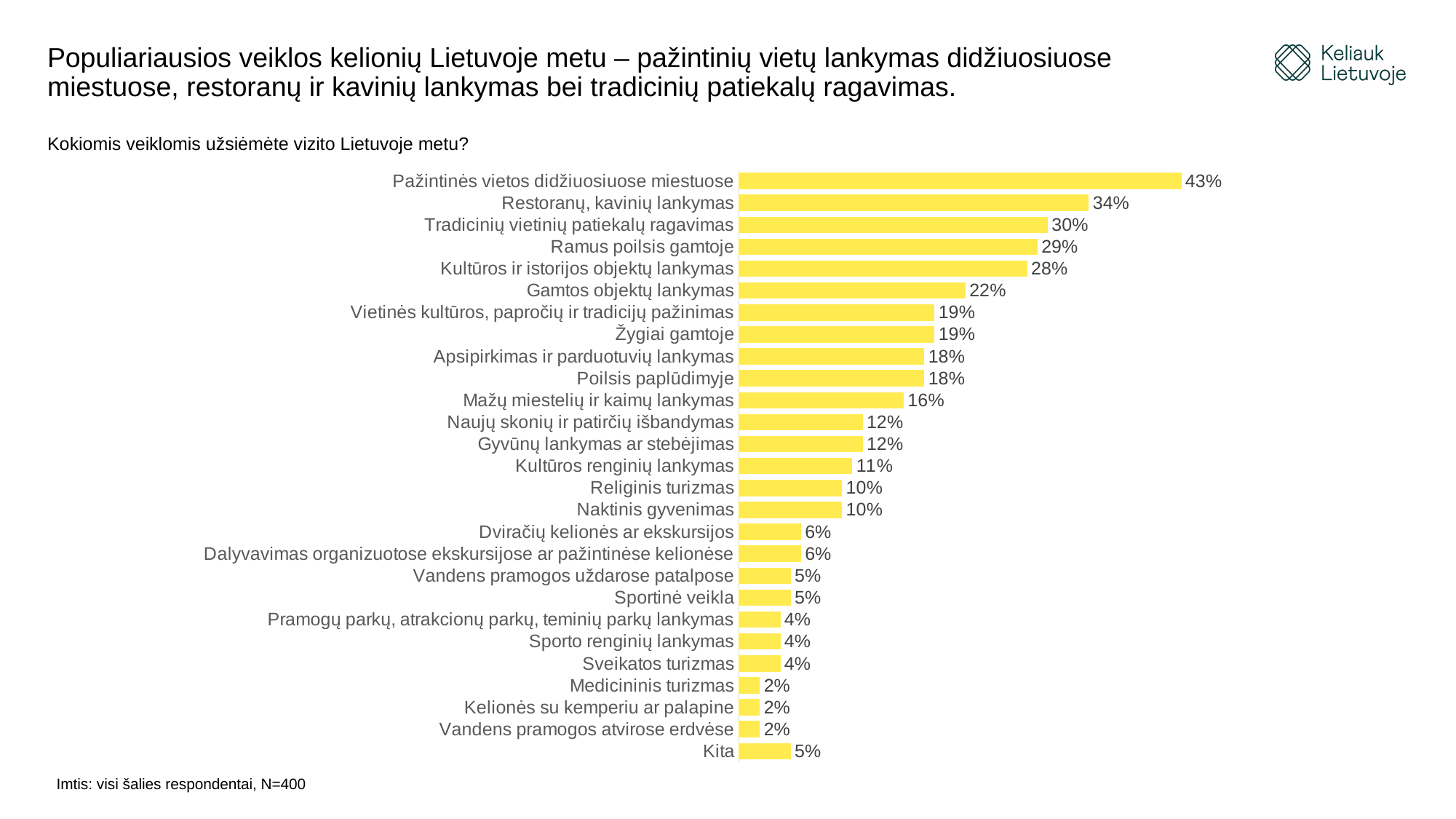
What is the value for "Ramus poilsis gamtoje"? 29% What colour are the bars in the chart? Yellow How many categories (bars) are shown in the chart? 27 What is the difference between "Gamtos objektų lankymas" and "Mažų miestelių ir kaimų lankymas"? 6% What is the difference between "Restoranų, kavinių lankymas" and "Tradicinių vietinių patiekalų ragavimas"? 4% Which activity has the highest percentage? Pažintinės vietos didžiuosiuose miestuose Which is larger: "Kultūros ir istorijos objektų lankymas" or "Gamtos objektų lankymas"? Kultūros ir istorijos objektų lankymas What type of chart is shown on the slide? Bar chart What is the value for "Kita"? 5% What percentage of respondents chose "Pažintinės vietos didžiuosiuose miestuose"? 43% What is the value for "Naktinis gyvenimas"? 10% What is the lowest value shown in the chart? 2%